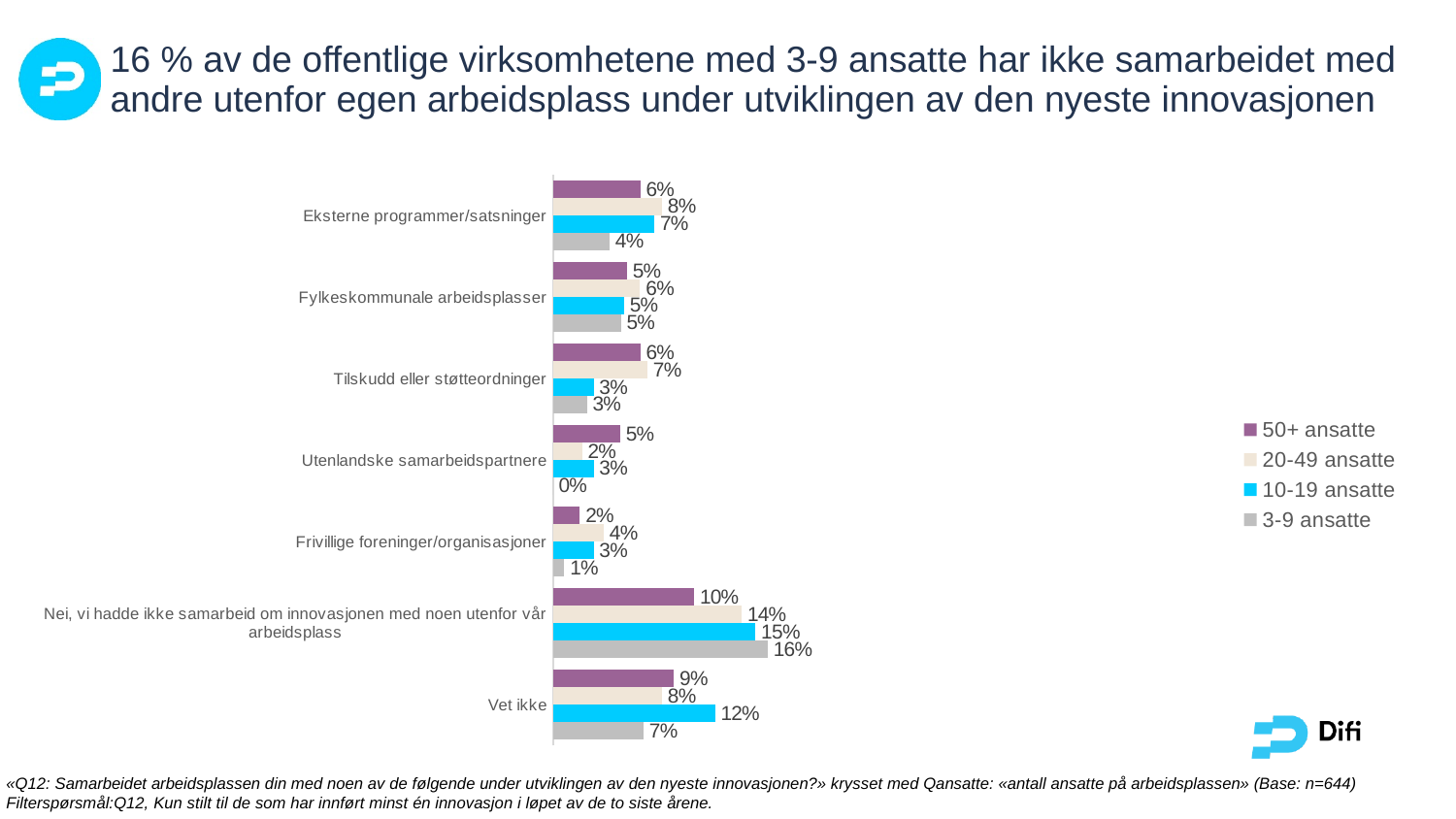
What is the value for '3-9 ansatte' in the category 'Utenlandske samarbeidspartnere'? 0% What is the value for '20-49 ansatte' in the category 'Eksterne programmer/satsninger'? 8% In the category 'Tilskudd eller støtteordninger', which is larger: the value for '20-49 ansatte' or for '10-19 ansatte'? 20-49 ansatte How many categories are shown on the chart? 7 Which category has the lowest value for the '3-9 ansatte' series? Utenlandske samarbeidspartnere Which category has the highest value for the '50+ ansatte' series? Nei, vi hadde ikke samarbeid om innovasjonen med noen utenfor vår arbeidsplass What kind of chart is shown on the slide? bar chart What is the difference between the '3-9 ansatte' and '50+ ansatte' values in the category 'Nei, vi hadde ikke samarbeid om innovasjonen med noen utenfor vår arbeidsplass'? 6% What is the value for '10-19 ansatte' in the category 'Vet ikke'? 12% How many series does the legend list? 4 What is the value for '3-9 ansatte' in the category 'Nei, vi hadde ikke samarbeid om innovasjonen med noen utenfor vår arbeidsplass'? 16% Which legend entry is shown in blue? 10-19 ansatte